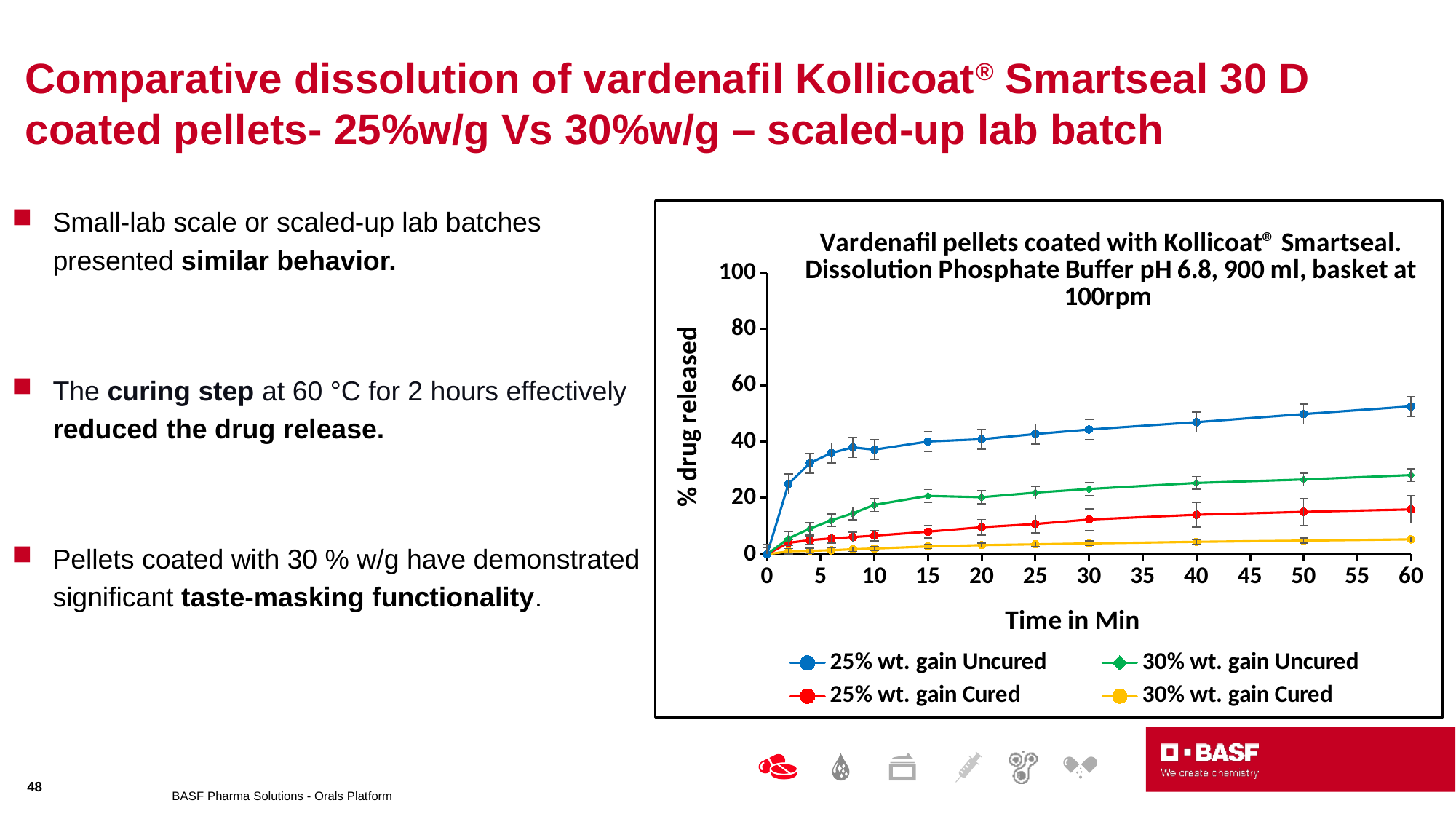
Is the value for 25% wt. gain Uncured at 60 minutes greater or less than 40? greater Is the value for 25% wt. gain Cured at 60 minutes greater or less than 20? less What kind of chart is shown on the slide? Line chart What is the label of the x axis? Time in Min Which series shows the lowest % drug released at 60 minutes? 30% wt. gain Cured Which colour is used for the 30% wt. gain Cured series? Yellow How many series does the legend list? 4 Is the value for 30% wt. gain Cured at 60 minutes greater or less than 20? less At 30 minutes, which series has the larger % drug released: 25% wt. gain Uncured or 30% wt. gain Uncured? 25% wt. gain Uncured Which series shows the highest % drug released at 60 minutes? 25% wt. gain Uncured Does the % drug released for 25% wt. gain Uncured rise or fall as time increases? Rise